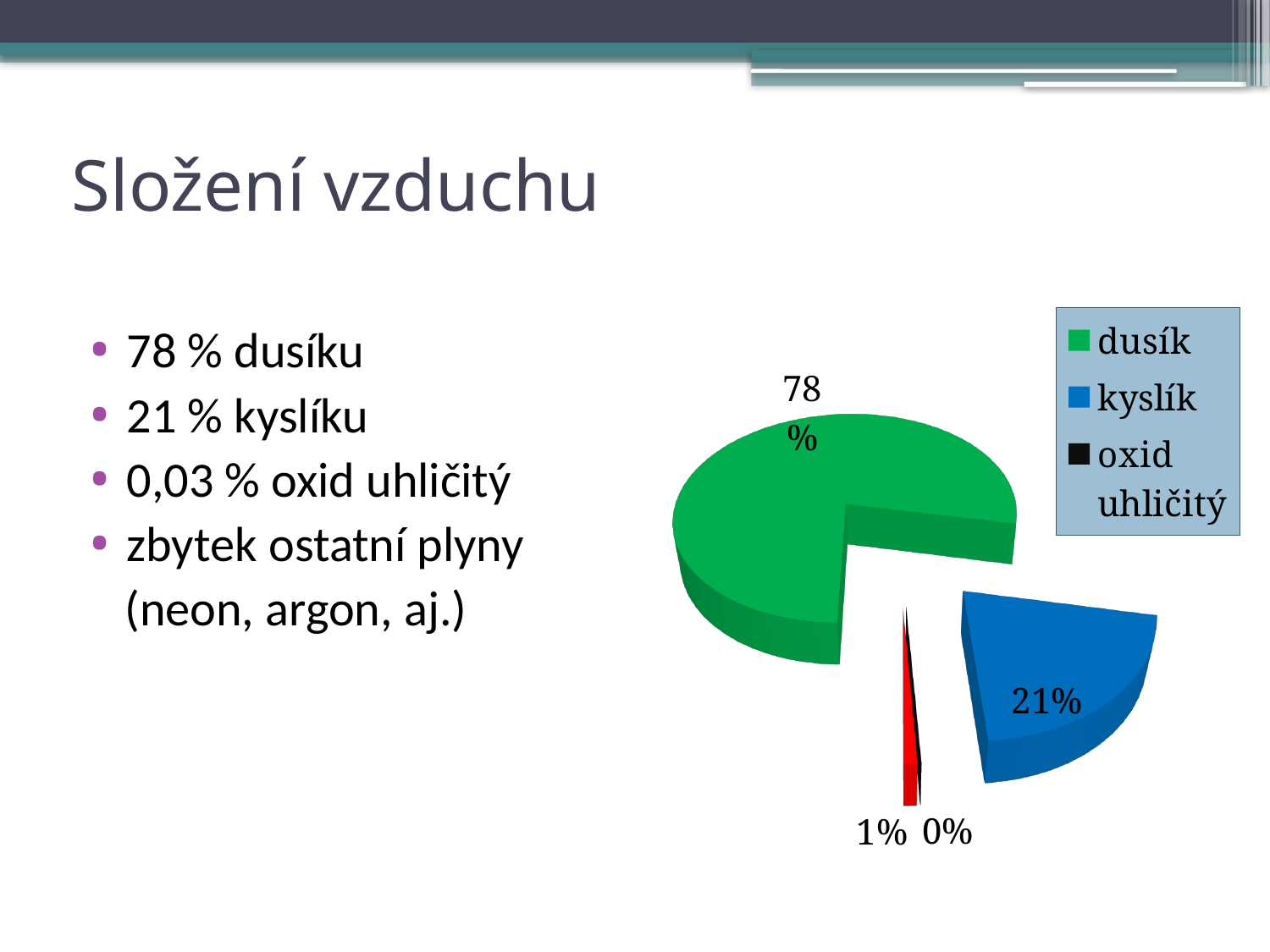
What colour is the dusík slice in the pie chart? green How many data labels are shown on the pie chart? 4 What percentage is shown for oxid uhličitý in the pie chart? 0% What share of the pie does kyslík have? 21% Which is larger in the pie chart, dusík or kyslík? dusík Which of the legend categories has the smallest slice of the pie? oxid uhličitý What is the difference in percentage points between the dusík slice and the kyslík slice? 57 Which category has the largest slice of the pie? dusík What colour is the kyslík slice in the pie chart? blue How many entries does the legend of the pie chart list? 3 What share of the pie does dusík have? 78% What kind of chart is shown on the slide? pie chart